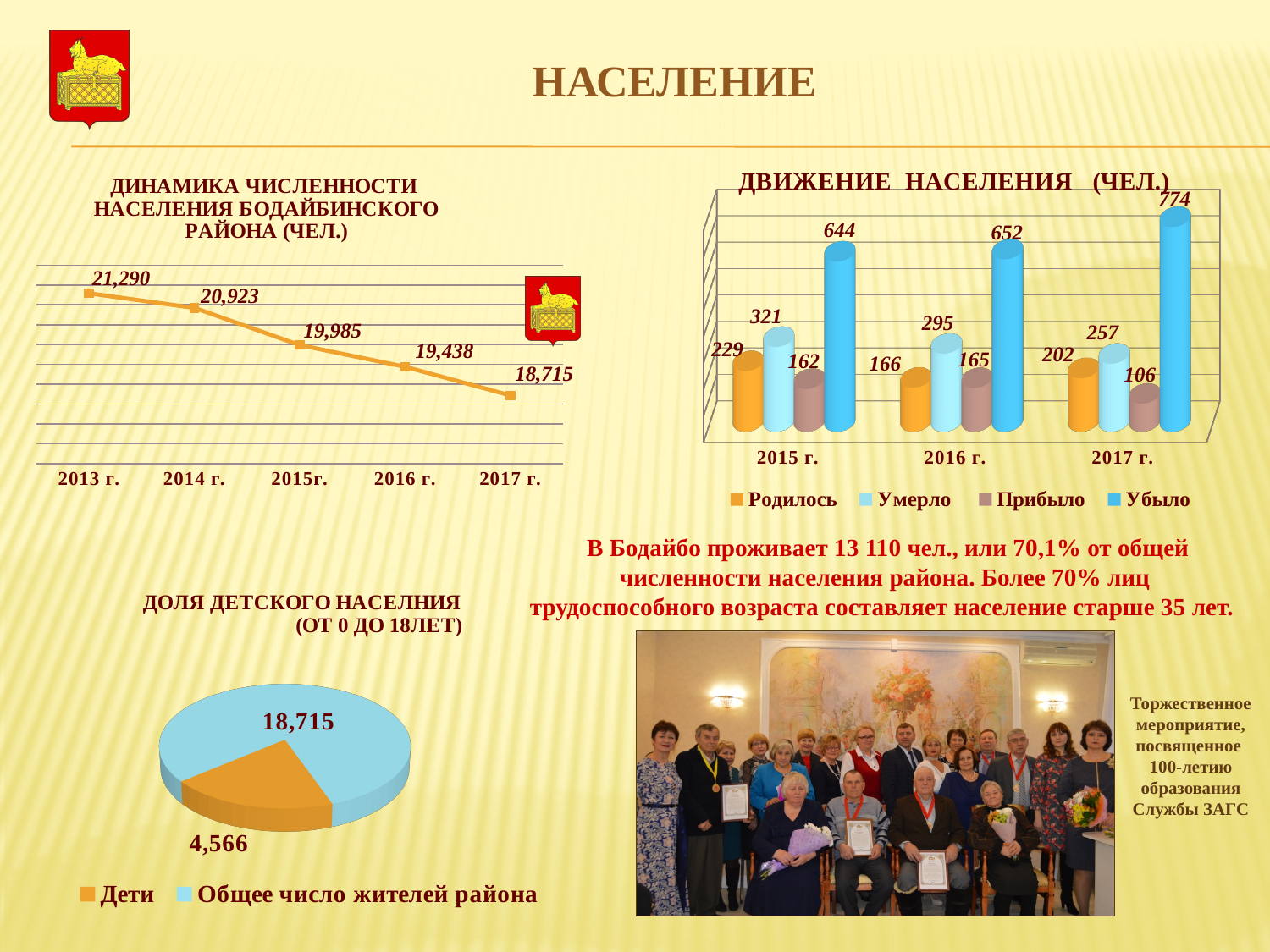
In the 'Доля детского населения (от 0 до 18 лет)' pie chart, what is the value for Дети? 4,566 In the 'Движение населения (чел.)' chart, what is the difference between Убыло and Родилось for 2017 г.? 572 What kind of chart is the 'Динамика численности населения Бодайбинского района (чел.)' chart? line chart In the 'Динамика численности населения Бодайбинского района (чел.)' chart, do the values rise or fall from 2013 г. to 2017 г.? fall How many series does the legend of the 'Движение населения (чел.)' chart list? 4 In the 'Движение населения (чел.)' chart, what is the value of Родилось for 2016 г.? 166 In the 'Движение населения (чел.)' chart, which is larger for 2015 г.: Родилось or Умерло? Умерло How many data points are plotted in the 'Динамика численности населения Бодайбинского района (чел.)' chart? 5 In the 'Динамика численности населения Бодайбинского района (чел.)' chart, what is the difference between the 2013 г. and 2017 г. values? 2,575 In the 'Движение населения (чел.)' chart, in which year is Убыло highest? 2017 г. In the 'Движение населения (чел.)' chart, what is the value of Убыло for 2017 г.? 774 In the 'Динамика численности населения Бодайбинского района (чел.)' chart, what is the value for 2015 г.? 19,985